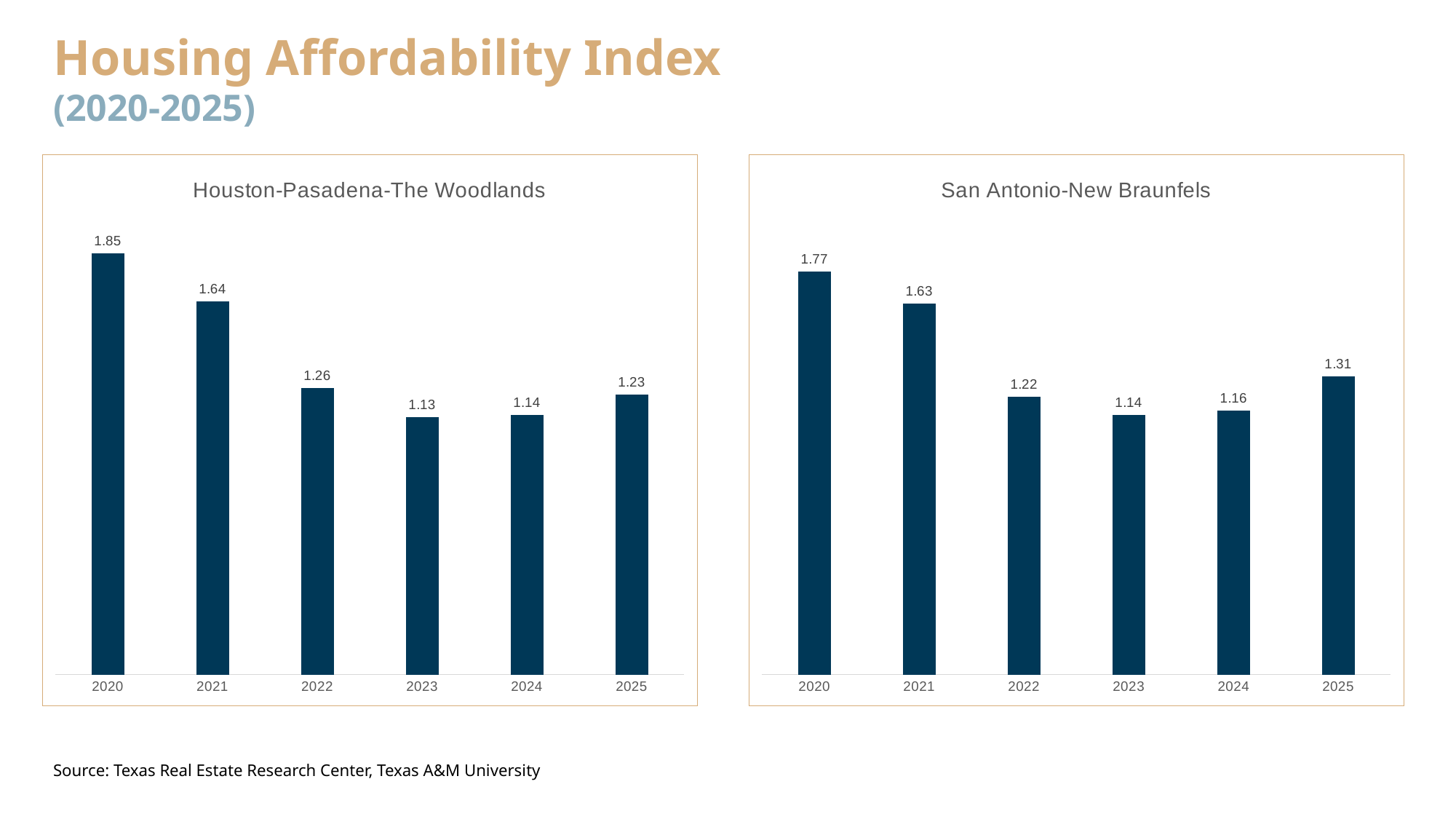
In the Houston-Pasadena-The Woodlands chart, which year has the lowest value? 2023 In the Houston-Pasadena-The Woodlands chart, what is the difference between the 2020 and 2021 values? 0.21 In the Houston-Pasadena-The Woodlands chart, do the values generally rise or fall from 2020 to 2023? Fall What kind of chart is the San Antonio-New Braunfels chart? Bar chart In the Houston-Pasadena-The Woodlands chart, which is larger, the value for 2022 or the value for 2025? 2022 How many years are shown on the x axis of the Houston-Pasadena-The Woodlands chart? 6 In the Houston-Pasadena-The Woodlands chart, what is the Housing Affordability Index value for 2020? 1.85 What is the title of the chart on the right side of the slide? San Antonio-New Braunfels In the San Antonio-New Braunfels chart, what is the value for 2025? 1.31 In the San Antonio-New Braunfels chart, which year has the highest value? 2020 In the San Antonio-New Braunfels chart, which is larger, the value for 2021 or the value for 2025? 2021 In the San Antonio-New Braunfels chart, what is the difference between the 2022 and 2023 values? 0.08